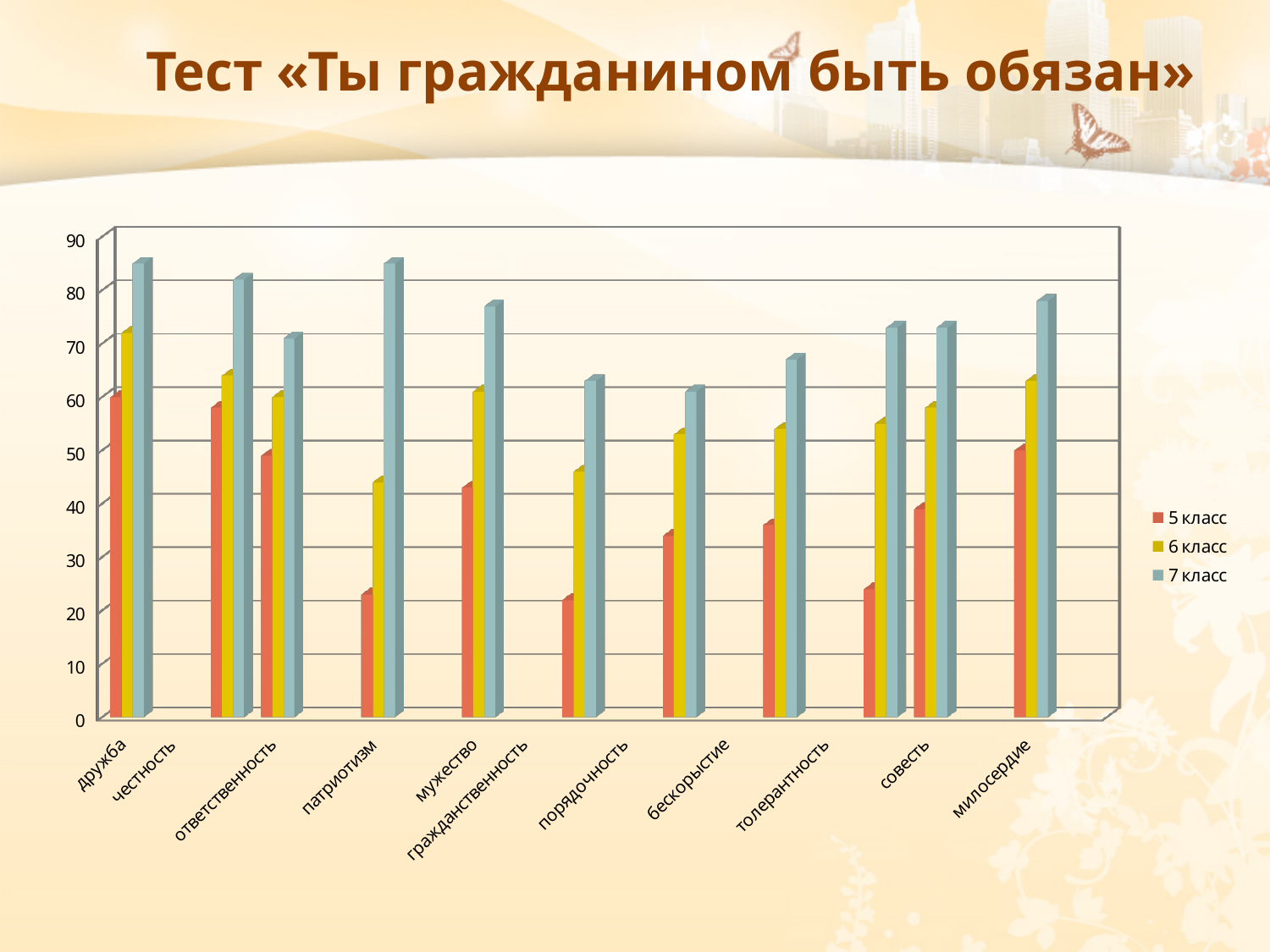
How many series does the legend list? 3 Is the value for 5 класс for патриотизм greater or less than 30? less What is the title of the slide above the chart? Тест «Ты гражданином быть обязан» Which category has the highest value for 6 класс? дружба Which series has the highest value for дружба? 7 класс Is the value for 5 класс for гражданственность greater or less than 30? less What kind of chart is shown on the slide? bar chart Is the value for 7 класс for порядочность greater or less than 50? greater How many categories are shown on the x axis? 11 Which is larger for 5 класс: дружба or патриотизм? дружба Which is larger for 7 класс: дружба or порядочность? дружба